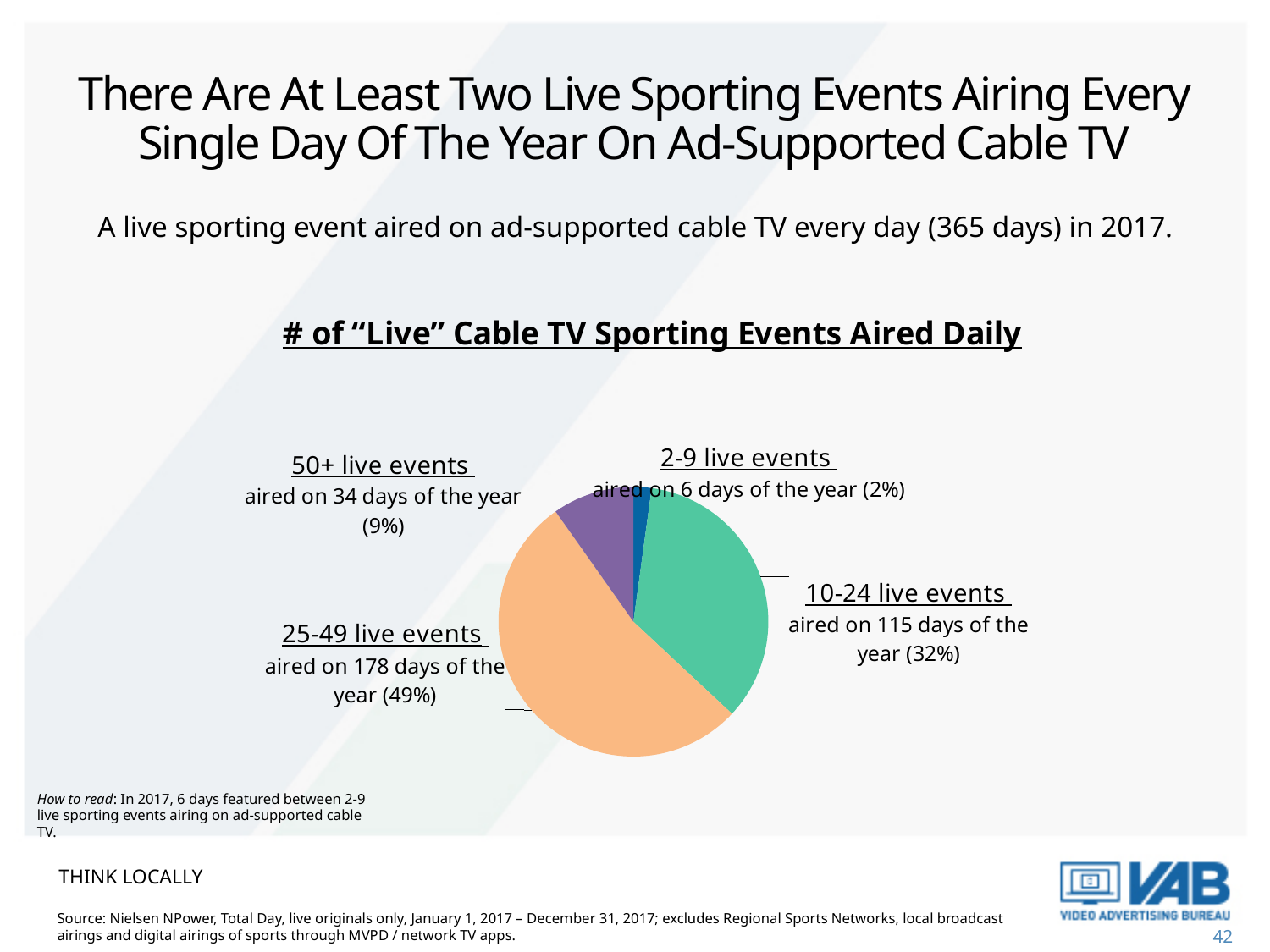
On how many days of the year did 25-49 live events air? 178 days How many slices does the pie chart have? 4 What is the title of the chart? # of "Live" Cable TV Sporting Events Aired Daily Which category accounts for the largest share of days? 25-49 live events What share of the year did 25-49 live events air? 49% Which category accounts for the smallest share of days? 2-9 live events On how many days of the year did 10-24 live events air? 115 days What kind of chart is shown on the slide? pie chart Which had more days: 50+ live events or 10-24 live events? 10-24 live events What share of the year did 2-9 live events air? 2% On how many days of the year did 50+ live events air? 34 days How many more days had 25-49 live events than 10-24 live events? 63 days